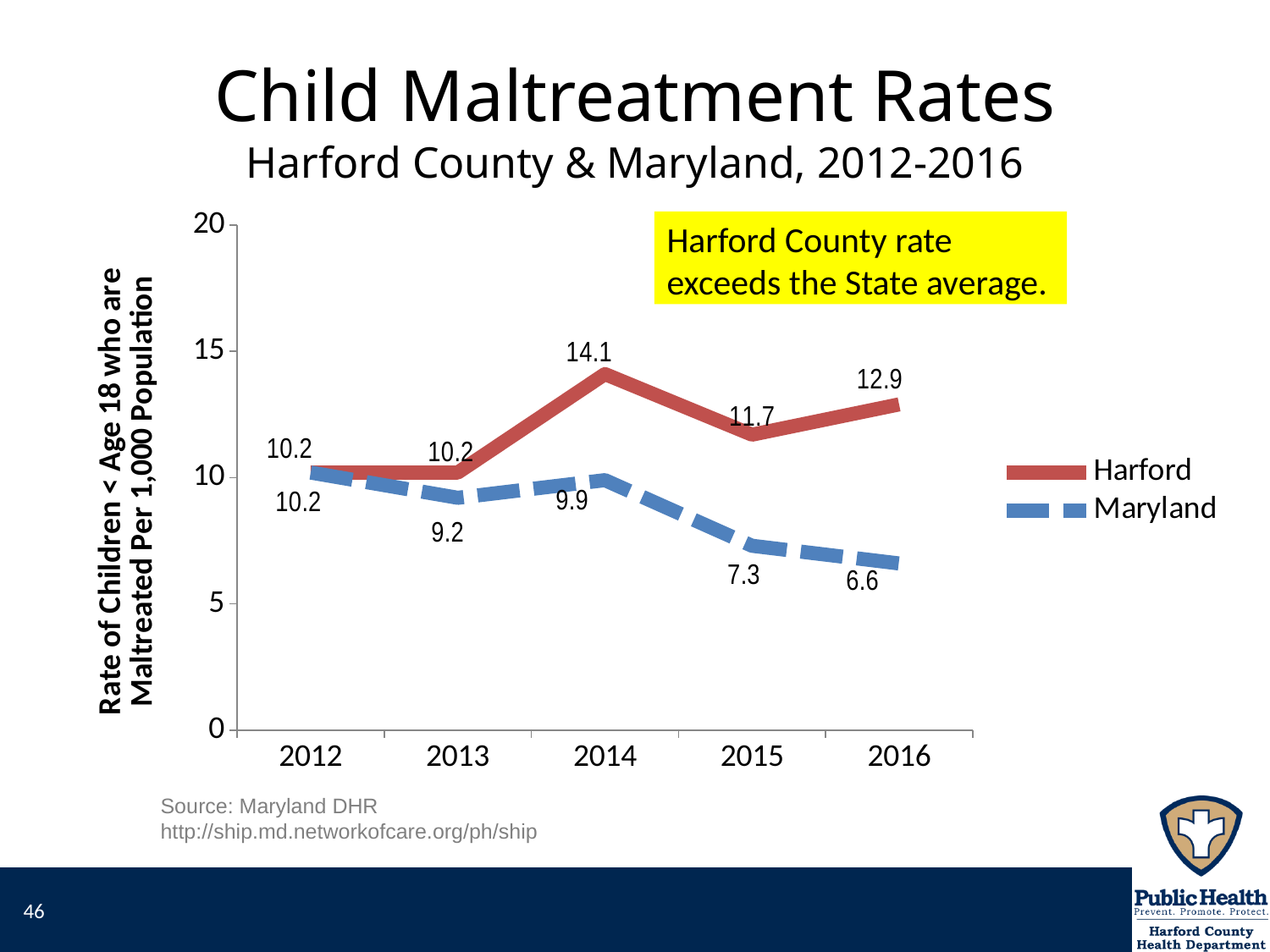
What was the Maryland rate in 2013? 9.2 In which year was the Maryland rate lowest? 2016 What kind of chart is shown on the slide? Line chart What is the difference between the Harford and Maryland rates in 2016? 6.3 How many series does the legend list? 2 What was the Harford child maltreatment rate in 2014? 14.1 How many years are plotted on the x axis? 5 Does the Maryland rate generally rise or fall from 2012 to 2016? Fall Which series had the higher rate in 2015, Harford or Maryland? Harford What is the difference between the Harford rates in 2014 and 2015? 2.4 What was the Maryland child maltreatment rate in 2016? 6.6 In which year was the Harford rate highest? 2014